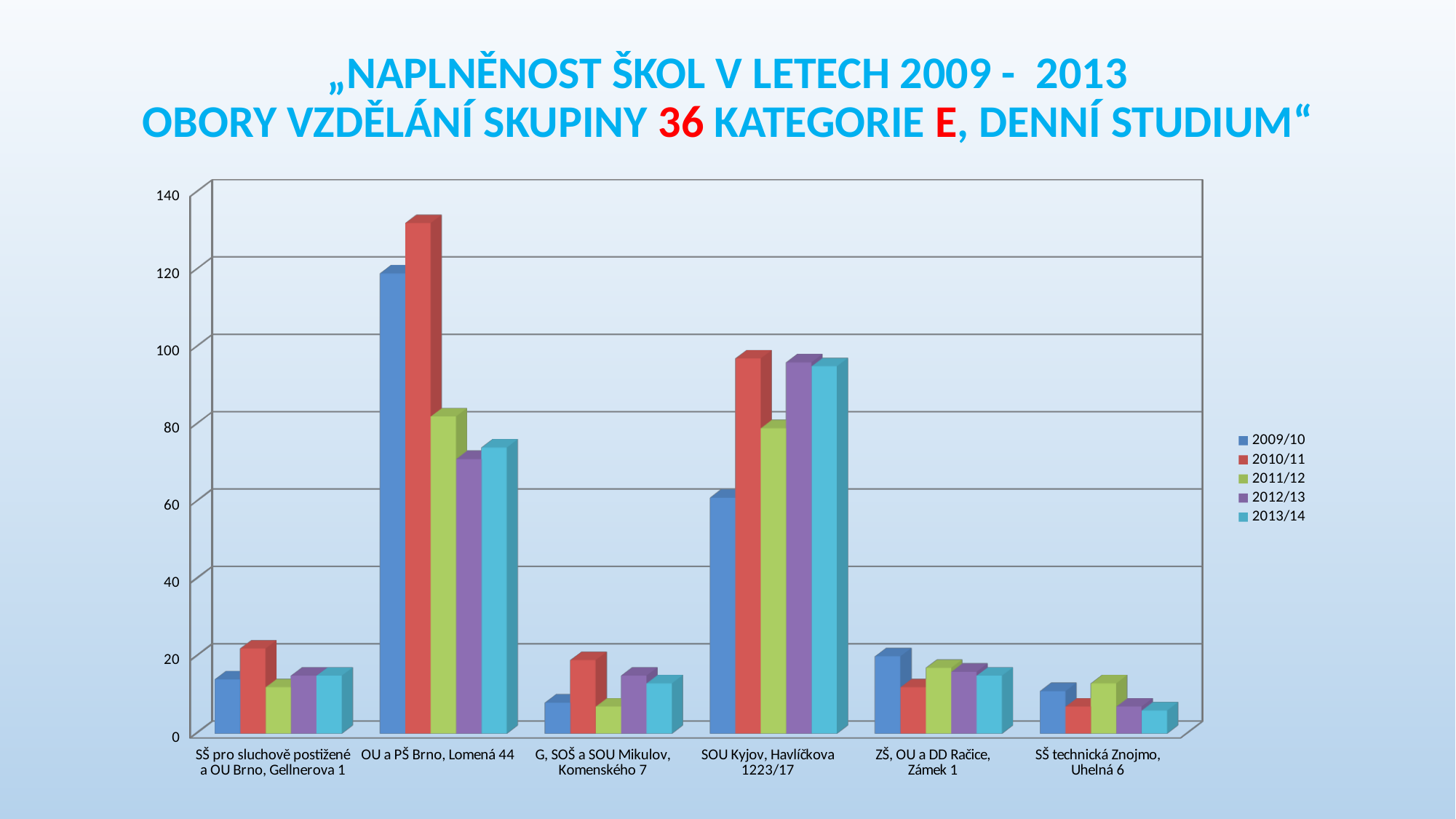
How many schools (categories) are shown on the x axis? 6 What is the first entry listed in the legend? 2009/10 How many series does the legend list? 5 Is the 2009/10 value for SOU Kyjov, Havlíčkova 1223/17 greater or less than 80? less For SOU Kyjov, Havlíčkova 1223/17, which is larger: the 2010/11 value or the 2011/12 value? 2010/11 Is the 2012/13 value for SOU Kyjov, Havlíčkova 1223/17 greater or less than 80? greater Is the 2011/12 value for OU a PŠ Brno, Lomená 44 greater or less than 100? less What kind of chart is shown on the slide? bar chart Which school has the lowest value for 2013/14? SŠ technická Znojmo, Uhelná 6 Which school has the highest value for 2010/11? OU a PŠ Brno, Lomená 44 Which is larger for 2009/10: OU a PŠ Brno, Lomená 44 or SOU Kyjov, Havlíčkova 1223/17? OU a PŠ Brno, Lomená 44